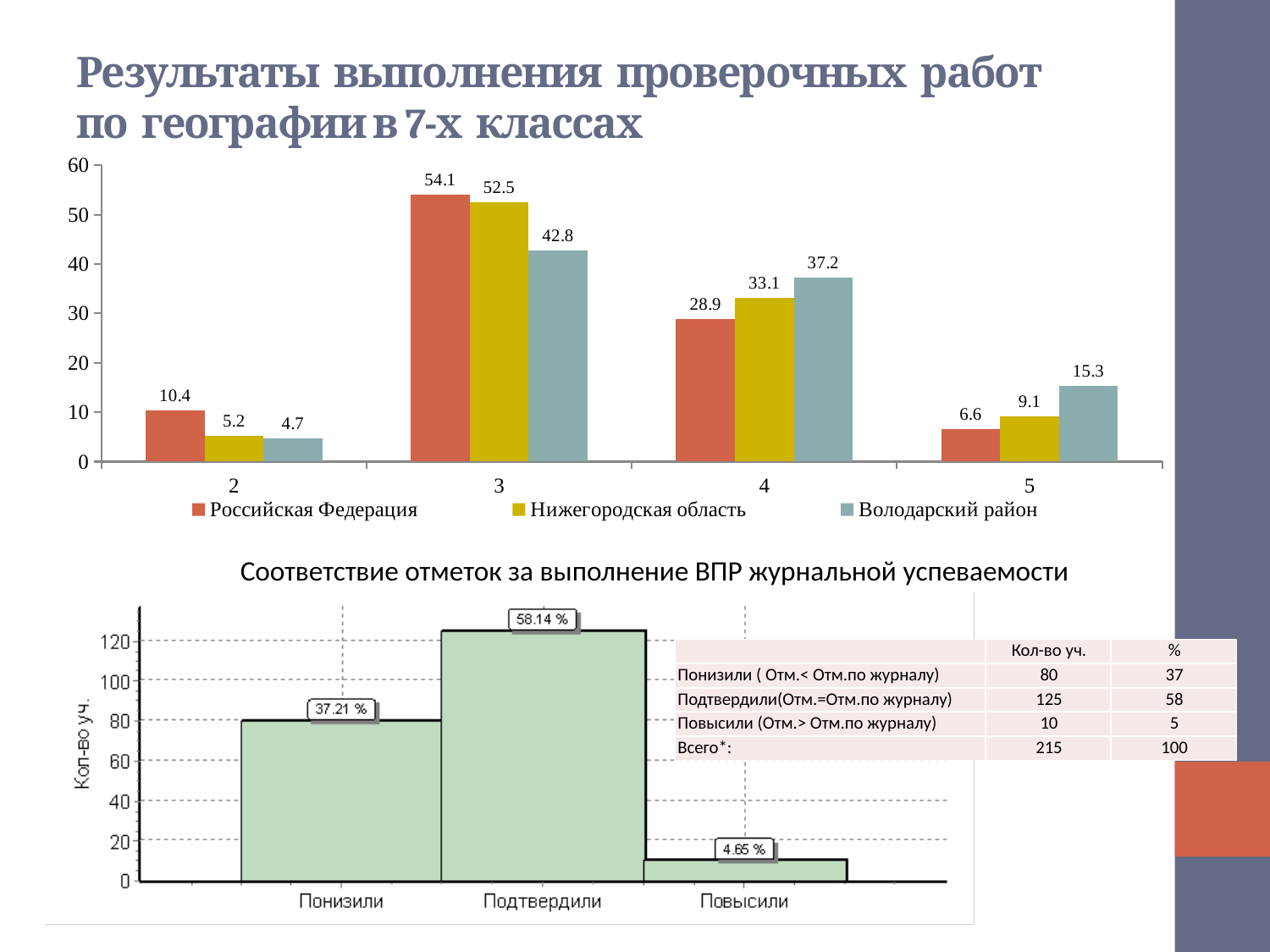
What kind of chart is the bottom chart titled 'Соответствие отметок за выполнение ВПР журнальной успеваемости'? bar chart In the top chart, what is the value for Володарский район in category 5? 15.3 In the top chart, which category has the highest value for Нижегородская область? 3 In the bottom chart, what percentage label is shown for Подтвердили? 58.14 % In the bottom chart, is the value for Повысили greater or less than 20? less In the bottom chart, which category has the lowest bar? Повысили In the top chart, which is larger in category 2: Российская Федерация or Нижегородская область? Российская Федерация In the top chart, what is the difference between Володарский район and Российская Федерация in category 4? 8.3 In the top chart, what is the value for Российская Федерация in category 3? 54.1 In the top chart, how many categories are shown on the x axis? 4 In the top chart, which category has the lowest value for Володарский район? 2 In the top chart, how many series does the legend list? 3